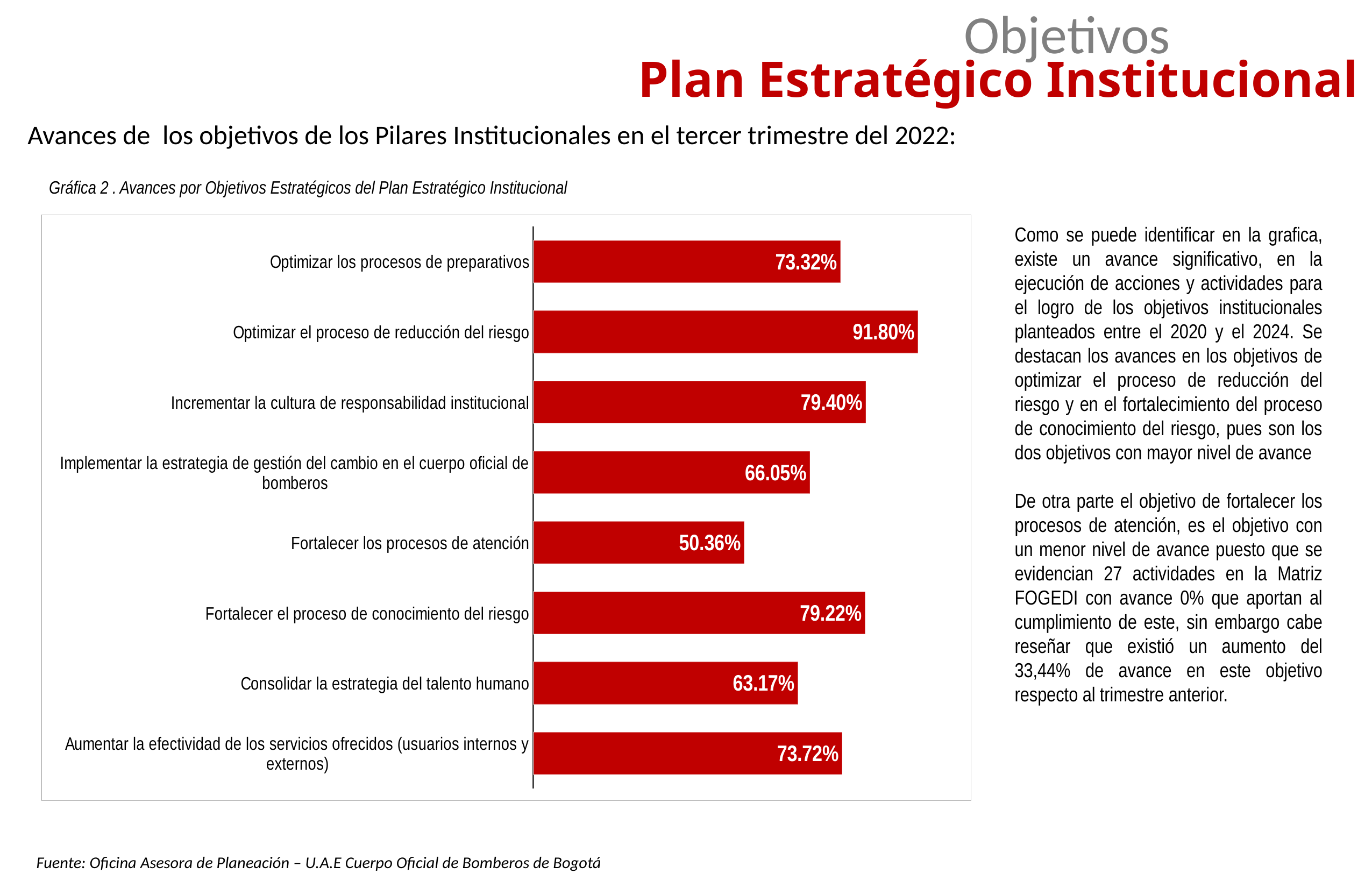
What is the value shown for 'Consolidar la estrategia del talento humano'? 63.17% Which is larger: the value for 'Optimizar el proceso de reducción del riesgo' or the value for 'Optimizar los procesos de preparativos'? Optimizar el proceso de reducción del riesgo What is the difference between 'Incrementar la cultura de responsabilidad institucional' and 'Implementar la estrategia de gestión del cambio en el cuerpo oficial de bomberos'? 13.35% Which objective has the lowest value in the chart? Fortalecer los procesos de atención What is the value shown for 'Optimizar el proceso de reducción del riesgo'? 91.80% What kind of chart is shown on the slide? Bar chart What is the value shown for 'Implementar la estrategia de gestión del cambio en el cuerpo oficial de bomberos'? 66.05% What is the difference between the highest value (91.80%) and the lowest value (50.36%)? 41.44% Which objective has the highest value in the chart? Optimizar el proceso de reducción del riesgo What is the value shown for 'Fortalecer los procesos de atención'? 50.36% What is the value shown for 'Aumentar la efectividad de los servicios ofrecidos (usuarios internos y externos)'? 73.72% How many objectives (bars) are shown in the chart? 8